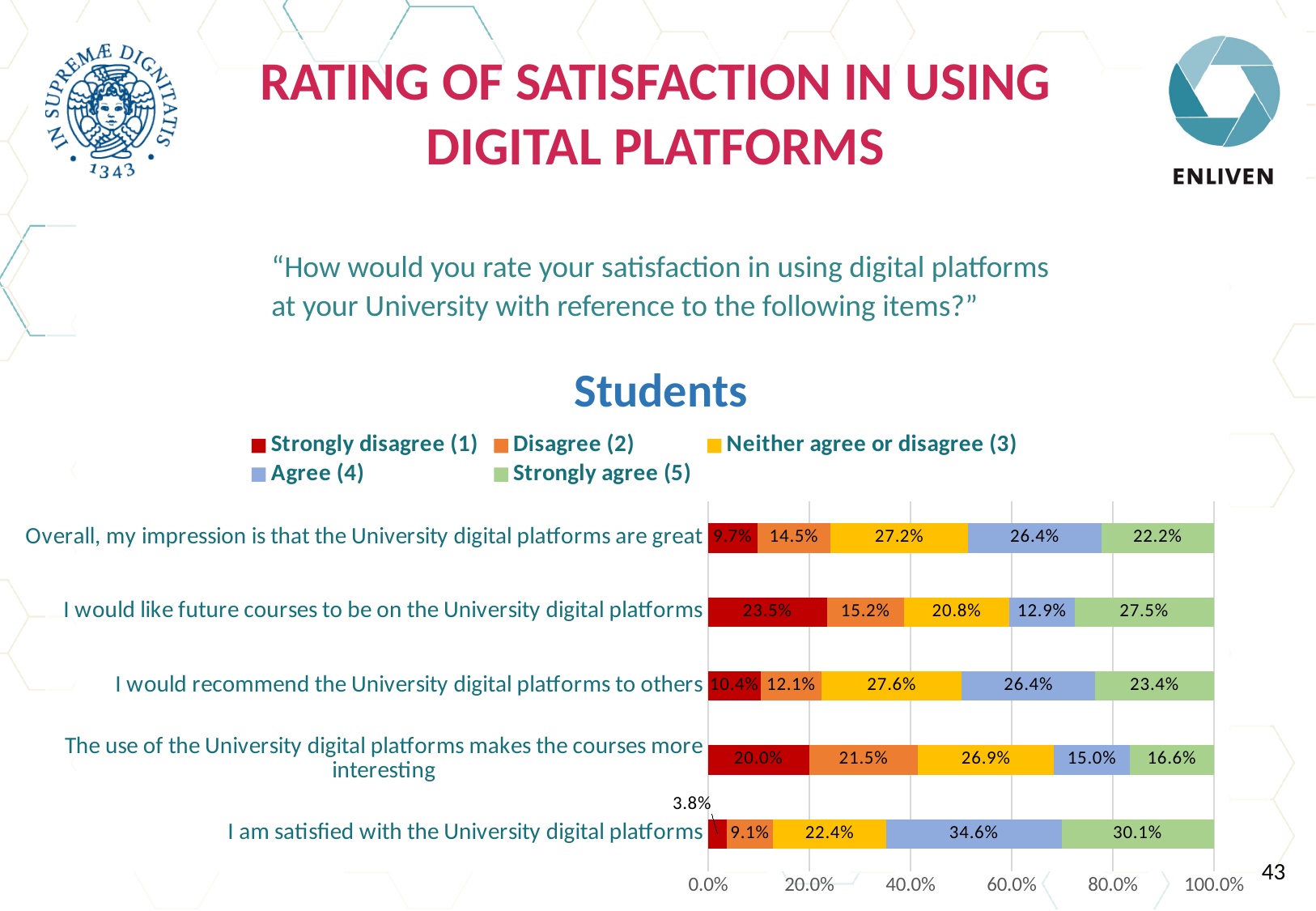
What percentage of students strongly agree (5) with "I am satisfied with the University digital platforms"? 30.1% How many items (bars) are shown in the Students chart? 5 What is the Neither agree or disagree (3) value for "I would recommend the University digital platforms to others"? 27.6% What kind of chart is shown on the slide? Stacked bar chart Which item has the larger Disagree (2) percentage: "The use of the University digital platforms makes the courses more interesting" or "Overall, my impression is that the University digital platforms are great"? The use of the University digital platforms makes the courses more interesting Which colour represents "Neither agree or disagree (3)" in the legend? Yellow Which item has the highest Agree (4) percentage? I am satisfied with the University digital platforms What percentage of students strongly disagree (1) with "I would like future courses to be on the University digital platforms"? 23.5% Which item has the lowest Strongly disagree (1) percentage? I am satisfied with the University digital platforms For "I am satisfied with the University digital platforms", what is the difference between the Agree (4) and Strongly agree (5) percentages? 4.5 percentage points What is the total of the stacked bar for "I am satisfied with the University digital platforms"? 100.0% How many series does the legend list? 5